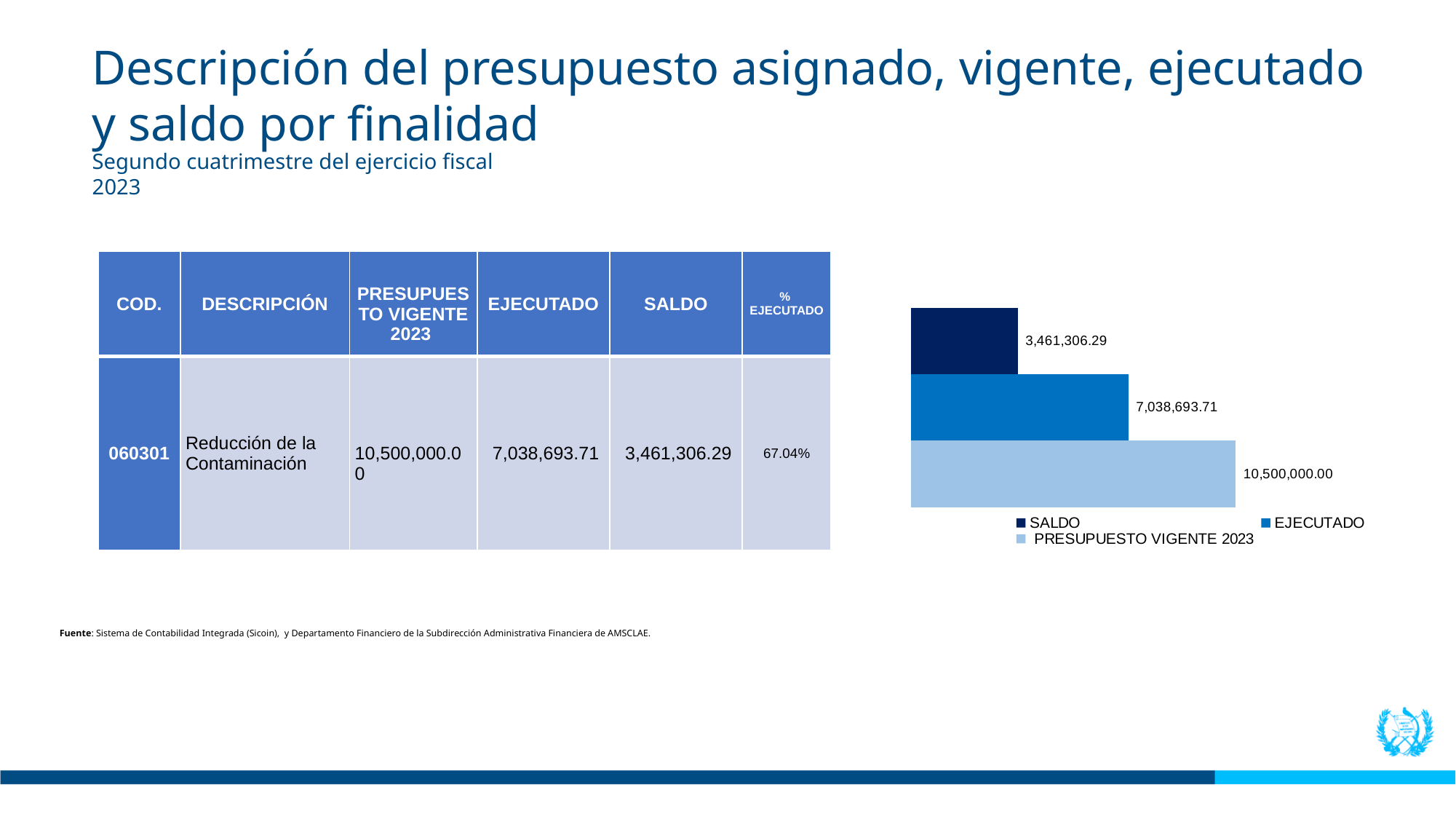
What value does the chart show for PRESUPUESTO VIGENTE 2023? 10,500,000.00 Which series has the lowest value in the chart? SALDO What value does the chart show for SALDO? 3,461,306.29 Which series is shown in the darkest blue in the chart? SALDO How many series does the chart legend list? 3 What value does the chart show for EJECUTADO? 7,038,693.71 What kind of chart is shown on the slide? Bar chart Which is larger in the chart, EJECUTADO or SALDO? EJECUTADO How many bars are plotted in the chart? 3 Which series has the highest value in the chart? PRESUPUESTO VIGENTE 2023 What is the difference between PRESUPUESTO VIGENTE 2023 and EJECUTADO in the chart? 3,461,306.29 What is the difference between EJECUTADO and SALDO in the chart? 3,577,387.42